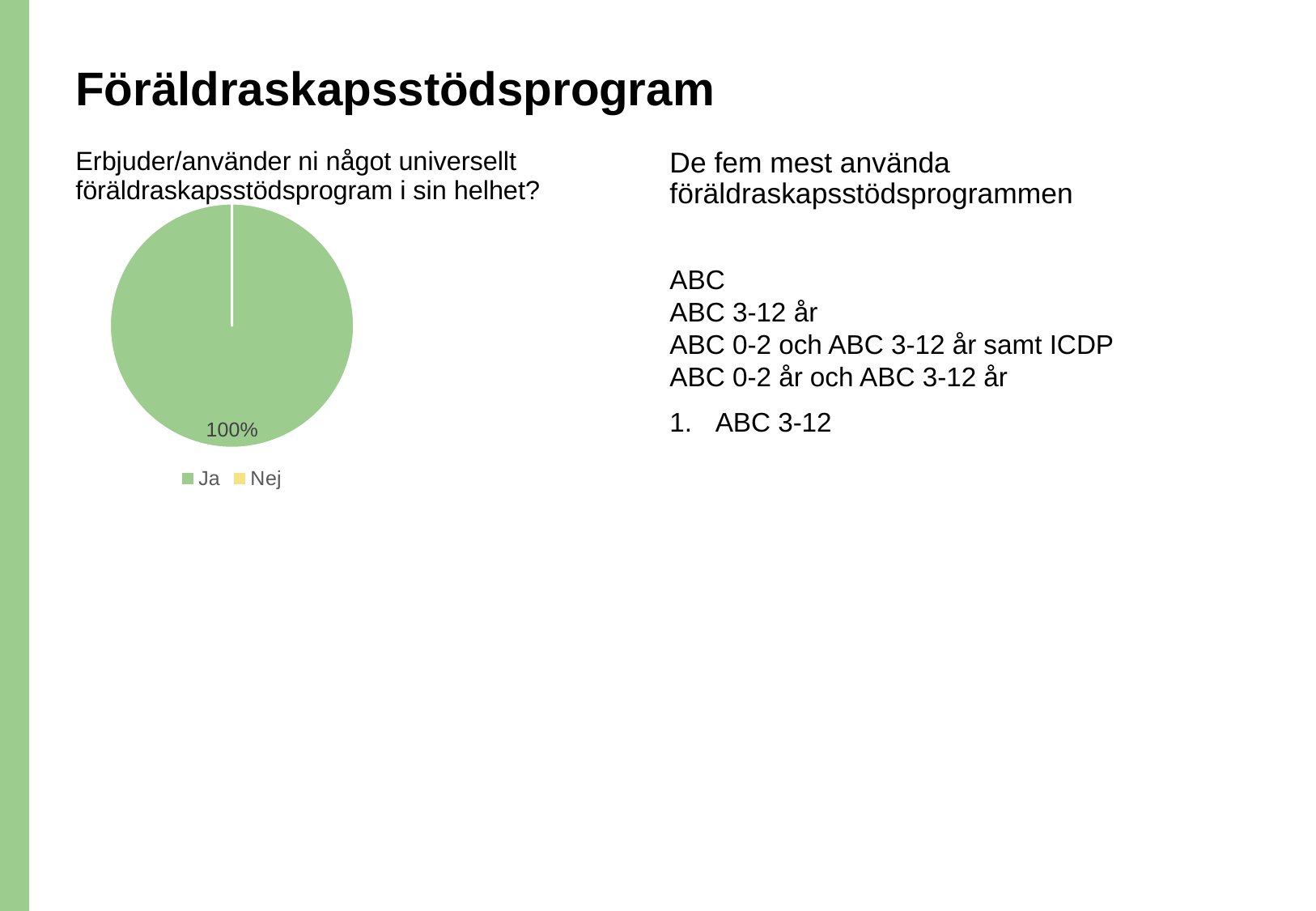
What colour represents "Ja" in the pie chart? green Which category has the largest share of the pie? Ja What kind of chart is shown on the slide? pie chart What is the title of the pie chart? Erbjuder/använder ni något universellt föräldraskapsstödsprogram i sin helhet? Which is larger, the share for "Ja" or the share for "Nej"? Ja How many entries does the legend of the pie chart list? 2 What is the only data label printed on the pie chart? 100% Is the share for "Nej" greater or less than 50%? less What share of the pie does "Ja" account for? 100%